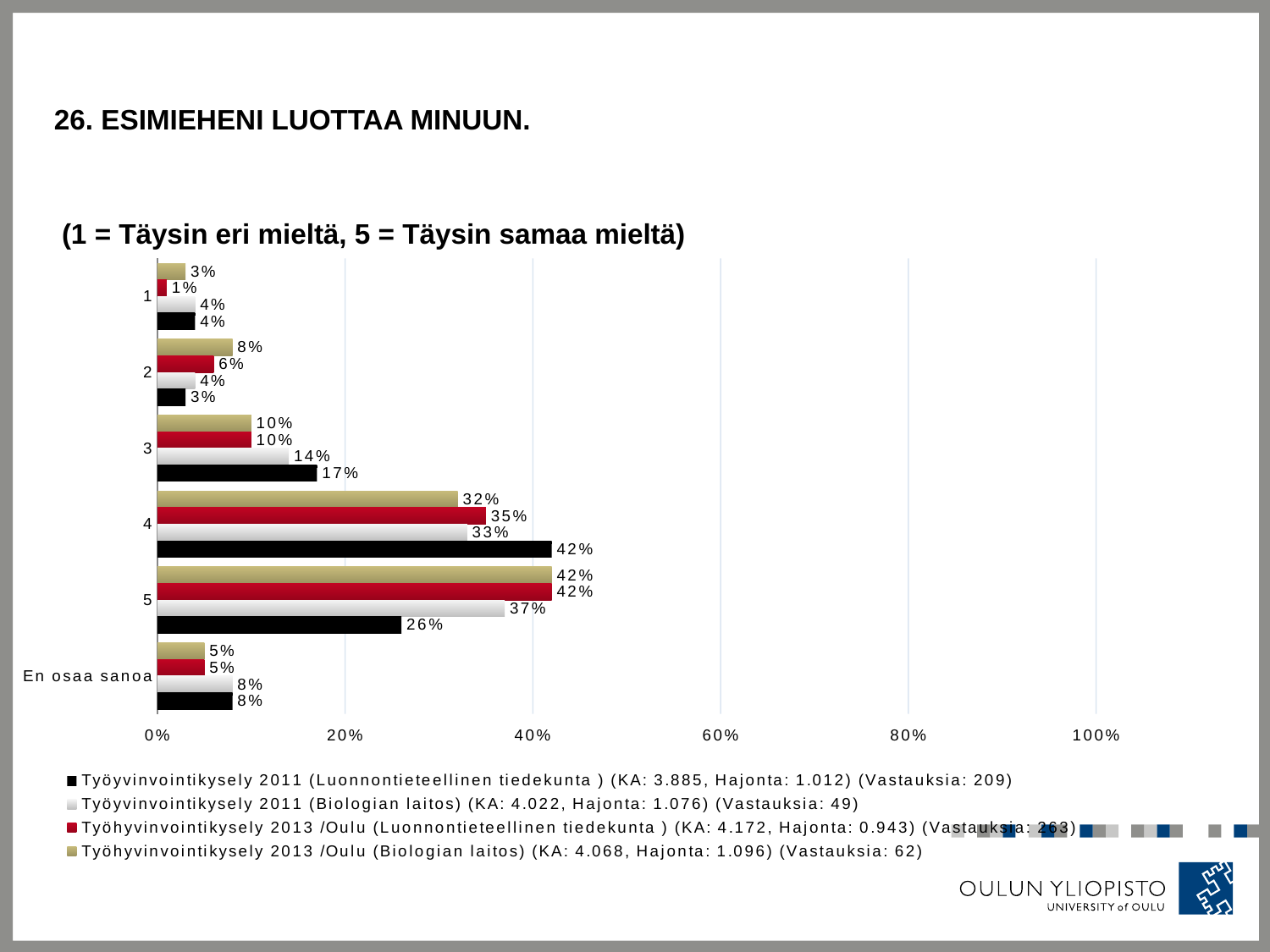
What is the value for category 1 in the Työhyvinvointikysely 2013 /Oulu (Luonnontieteellinen tiedekunta) series? 1% What is the value for En osaa sanoa in the Työyvinvointikysely 2011 (Biologian laitos) series? 8% How many series does the legend list? 4 For category 4, which is larger: the Työhyvinvointikysely 2013 /Oulu (Luonnontieteellinen tiedekunta) value or the Työyvinvointikysely 2011 (Biologian laitos) value? Työhyvinvointikysely 2013 /Oulu (Luonnontieteellinen tiedekunta) Which category has the highest value in the Työhyvinvointikysely 2013 /Oulu (Biologian laitos) series? 5 What is the value for category 4 in the Työyvinvointikysely 2011 (Luonnontieteellinen tiedekunta) series? 42% What is the difference between the Työyvinvointikysely 2011 (Luonnontieteellinen tiedekunta) value and the Työhyvinvointikysely 2013 /Oulu (Biologian laitos) value for category 5? 16% What is the value for category 5 in the Työyvinvointikysely 2011 (Luonnontieteellinen tiedekunta) series? 26% Which category has the lowest value in the Työhyvinvointikysely 2013 /Oulu (Luonnontieteellinen tiedekunta) series? 1 What type of chart is shown on the slide? bar chart What is the value for category 3 in the Työyvinvointikysely 2011 (Biologian laitos) series? 14% How many categories are shown on the vertical axis? 6